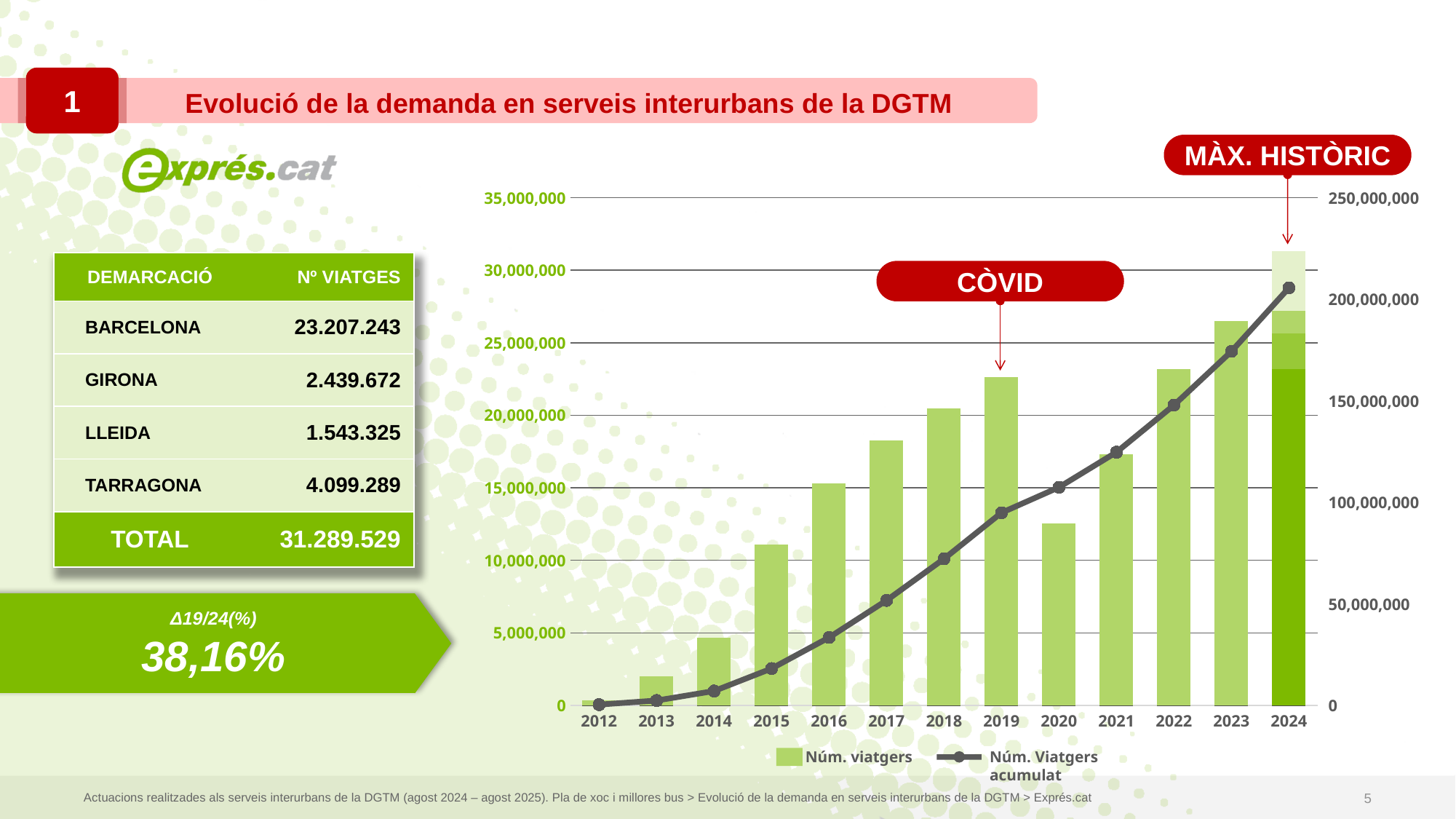
Which year on the chart is marked with the label 'MÀX. HISTÒRIC'? 2024 Which year has the shortest bar for Núm. viatgers? 2012 How many years are shown on the x axis of the chart? 13 Is the Núm. viatgers bar for 2013 greater or less than 5,000,000? less How many series does the chart legend list? 2 Does the Núm. Viatgers acumulat line rise or fall from 2012 to 2024? It rises Which year has the larger Núm. viatgers bar, 2021 or 2022? 2022 Is the Núm. viatgers bar for 2020 greater or less than 15,000,000? less Which year has the larger Núm. viatgers bar, 2019 or 2020? 2019 Is the Núm. viatgers bar for 2019 greater or less than 20,000,000? greater Which year has the tallest bar for Núm. viatgers? 2024 What kind of chart is shown on the slide? A bar chart combined with a line